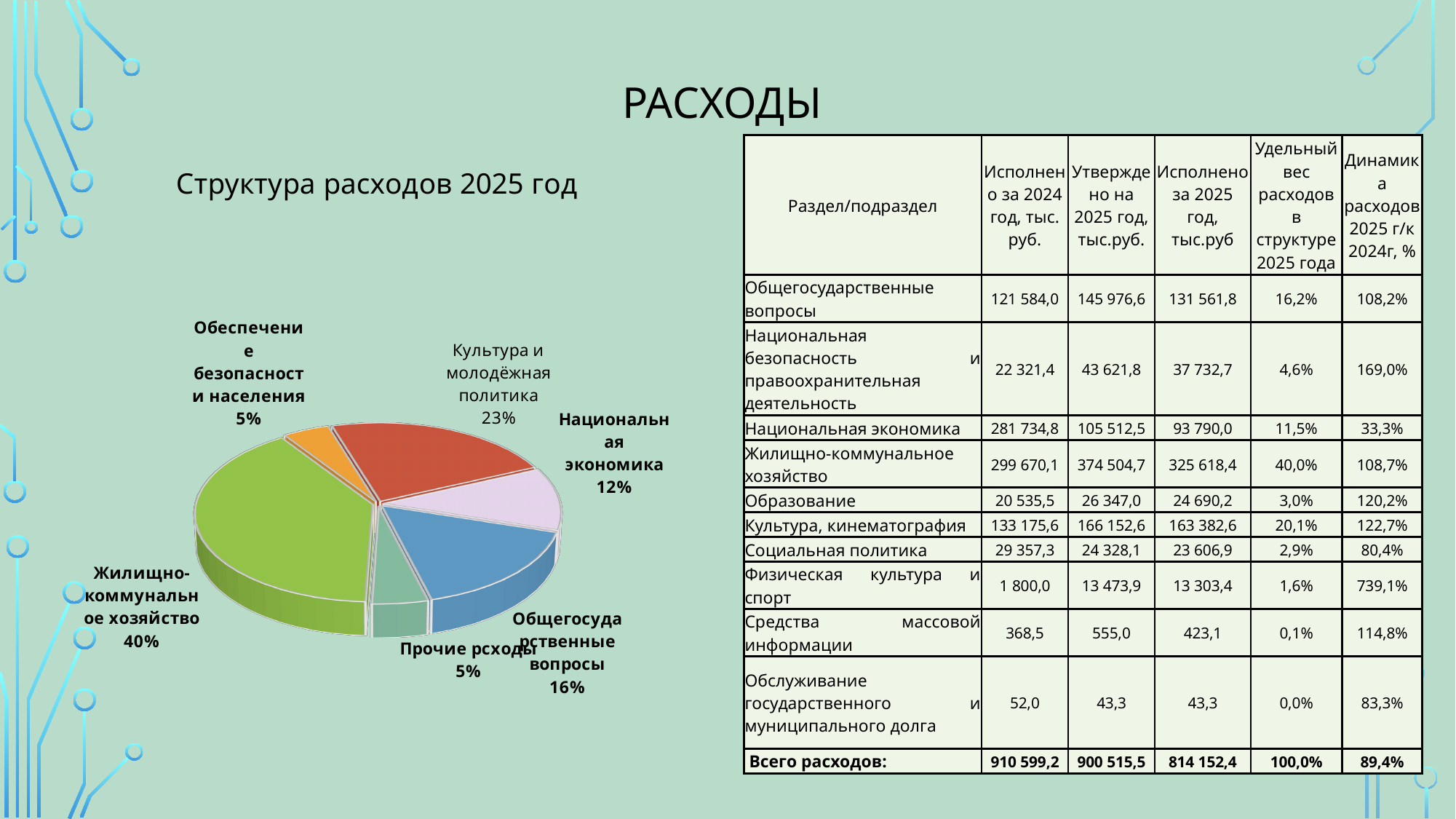
Which category has the largest slice in the pie chart? Жилищно-коммунальное хозяйство What type of chart is shown on the left of the slide? pie chart What share of the pie chart is Культура и молодёжная политика? 23% What share of the pie chart is Прочие расходы? 5% What is the title of the pie chart on the slide? Структура расходов 2025 год What share of the pie chart is Жилищно-коммунальное хозяйство? 40% What share of the pie chart is Общегосударственные вопросы? 16% In the pie chart, what is the difference in percentage points between Жилищно-коммунальное хозяйство and Общегосударственные вопросы? 24 In the pie chart, what is the combined share of Обеспечение безопасности населения and Прочие расходы? 10% What share of the pie chart is Национальная экономика? 12% In the pie chart, which is larger: Культура и молодёжная политика or Национальная экономика? Культура и молодёжная политика How many slices does the pie chart have? 6